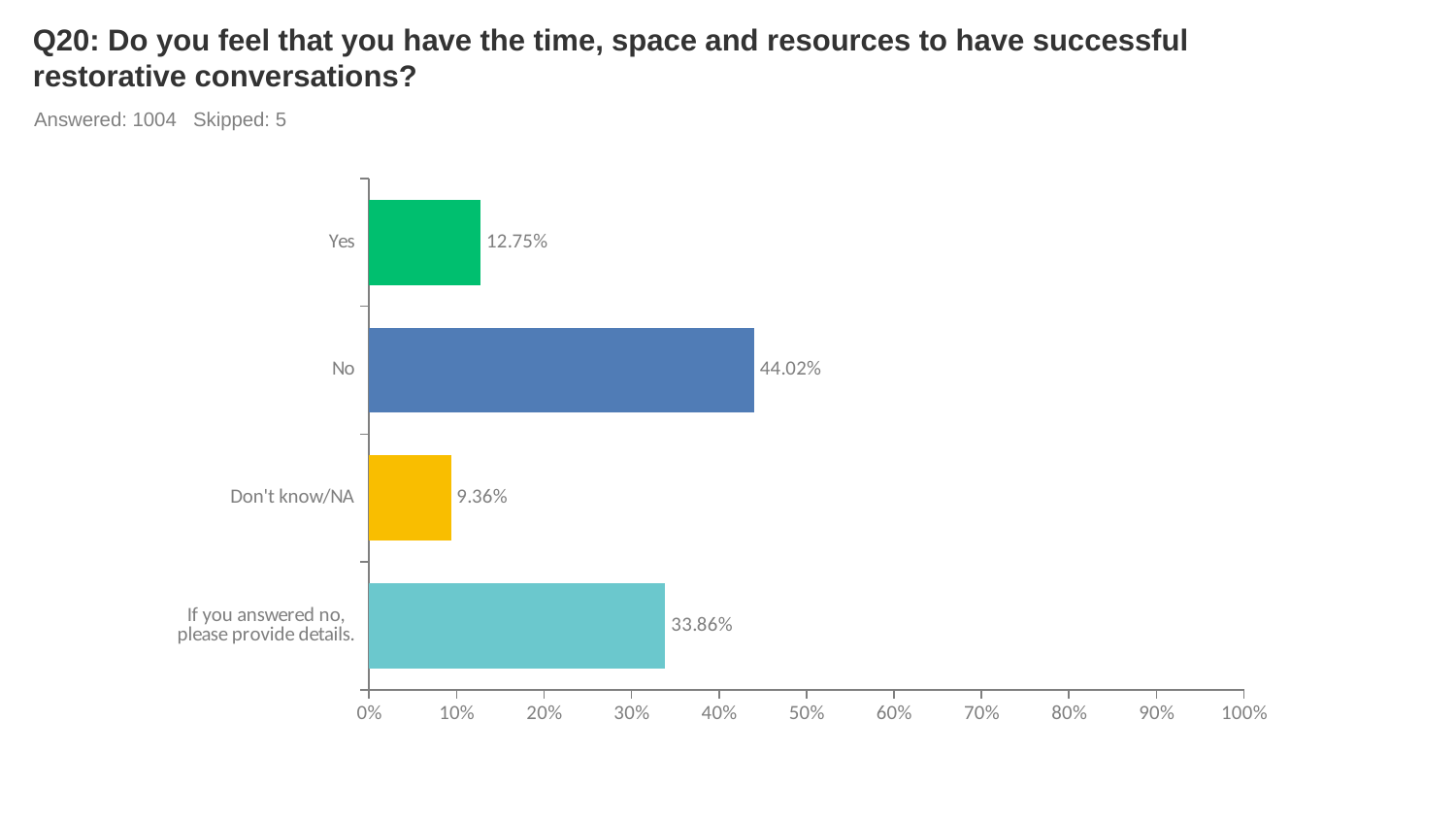
How many categories are shown in the chart? 4 Which category has the lowest value? Don't know/NA What percentage of respondents answered "No"? 44.02% Is the value for "No" greater or less than 40%? greater What kind of chart is shown on the slide? Bar chart Which category has the highest value? No What is the value for "If you answered no, please provide details."? 33.86% How many respondents answered the question, according to the slide? 1004 Which is larger, the value for "Yes" or the value for "Don't know/NA"? Yes What is the value for "Don't know/NA"? 9.36% What is the difference between the "No" and "Yes" values? 31.27% What percentage of respondents answered "Yes"? 12.75%